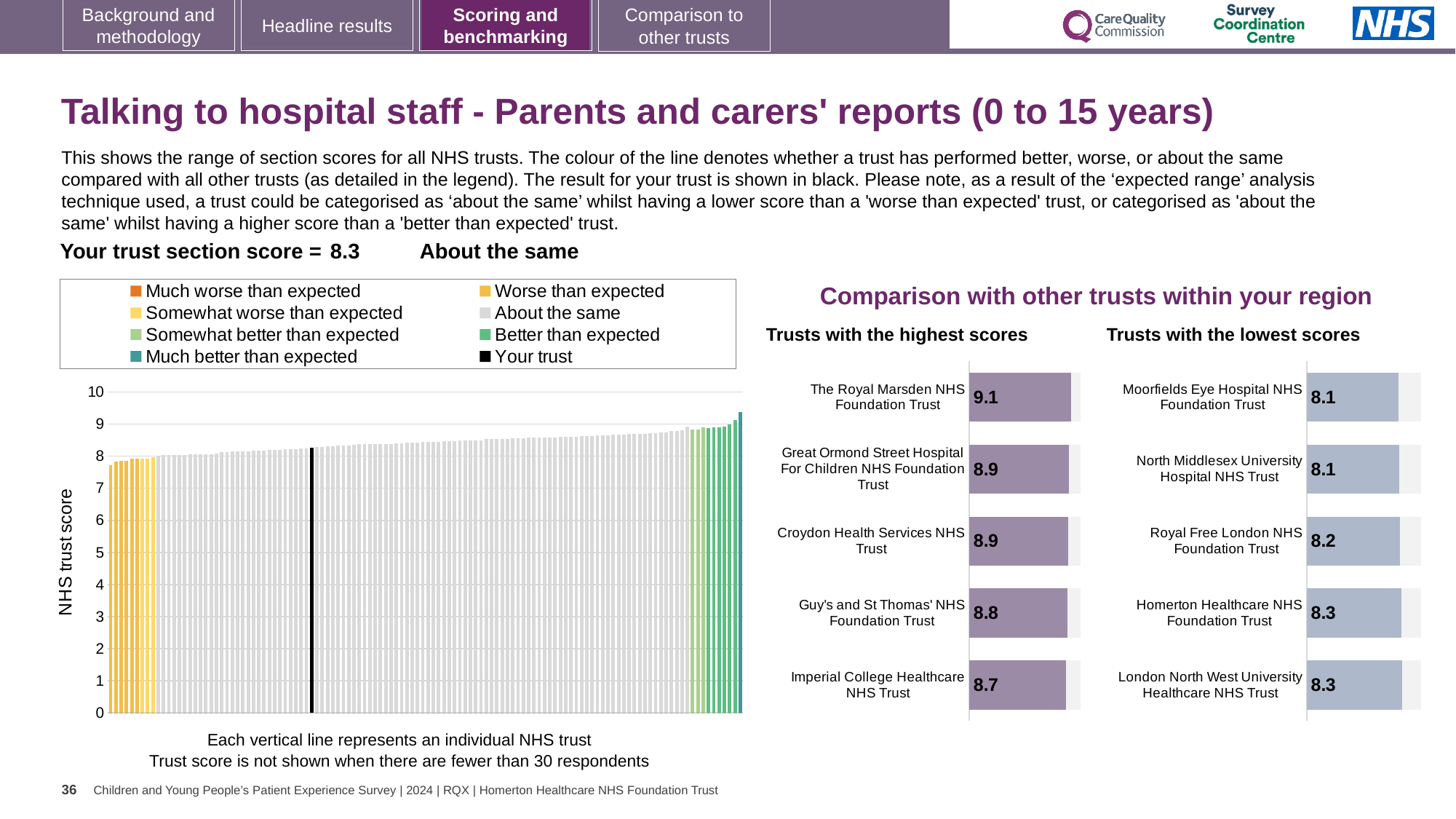
In the 'Trusts with the lowest scores' chart, what is the score for Homerton Healthcare NHS Foundation Trust? 8.3 In the large chart on the left, what is the label on the vertical axis? NHS trust score In the 'Trusts with the highest scores' chart, which has the higher score: Great Ormond Street Hospital For Children NHS Foundation Trust or Guy's and St Thomas' NHS Foundation Trust? Great Ormond Street Hospital For Children NHS Foundation Trust In the large chart on the left, is the value for the black 'Your trust' bar greater or less than 9? less What type of chart is the large chart on the left of the slide? bar chart In the 'Trusts with the highest scores' chart, which trust has the highest score? The Royal Marsden NHS Foundation Trust How many entries does the legend above the large chart on the left list? 8 In the 'Trusts with the highest scores' chart, what is the difference between the scores of The Royal Marsden NHS Foundation Trust and Imperial College Healthcare NHS Trust? 0.4 In the 'Trusts with the highest scores' chart, what is the score for Imperial College Healthcare NHS Trust? 8.7 In the 'Trusts with the lowest scores' chart, what is the score for Royal Free London NHS Foundation Trust? 8.2 How many trusts are shown in the 'Trusts with the highest scores' chart? 5 In the 'Trusts with the lowest scores' chart, what is the difference between the scores of Homerton Healthcare NHS Foundation Trust and Moorfields Eye Hospital NHS Foundation Trust? 0.2